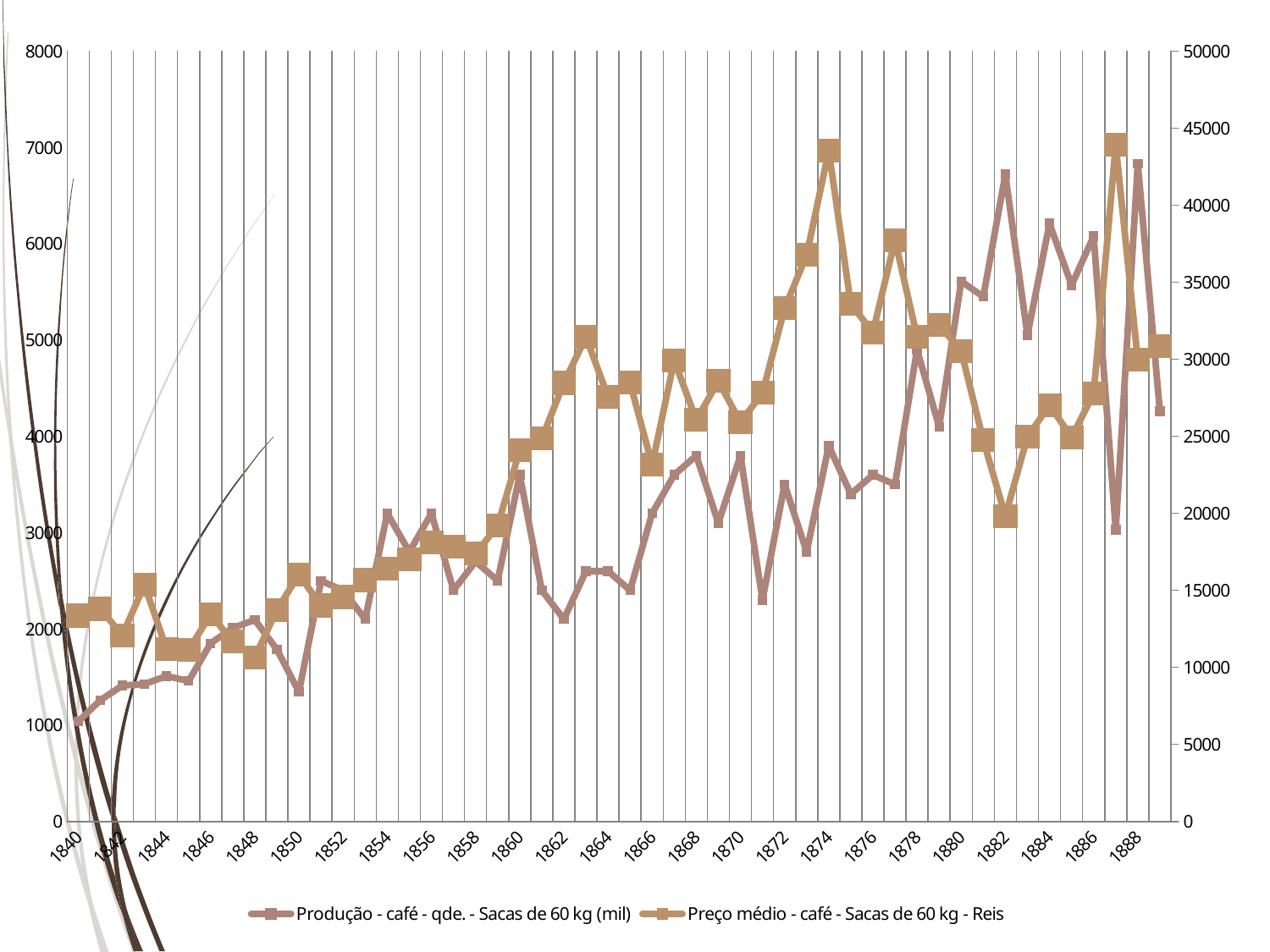
Which year has the lowest value for the series 'Produção - café - qde. - Sacas de 60 kg (mil)'? 1840 Which is larger for 'Produção - café - qde. - Sacas de 60 kg (mil)': the value in 1850 or the value in 1882? 1882 Is the value for 'Preço médio - café - Sacas de 60 kg - Reis' in 1882 greater or less than 25000? less Overall, does the series 'Produção - café - qde. - Sacas de 60 kg (mil)' rise or fall from 1840 to 1888? rise What is the name of the series plotted in the darker gold colour with square markers? Preço médio - café - Sacas de 60 kg - Reis What kind of chart is shown on the slide? line chart What is the highest value shown on the right-hand vertical axis? 50000 Is the value for 'Produção - café - qde. - Sacas de 60 kg (mil)' in 1840 greater or less than 2000? less Is the value for 'Produção - café - qde. - Sacas de 60 kg (mil)' in 1882 greater or less than 6000? greater How many series does the legend list? 2